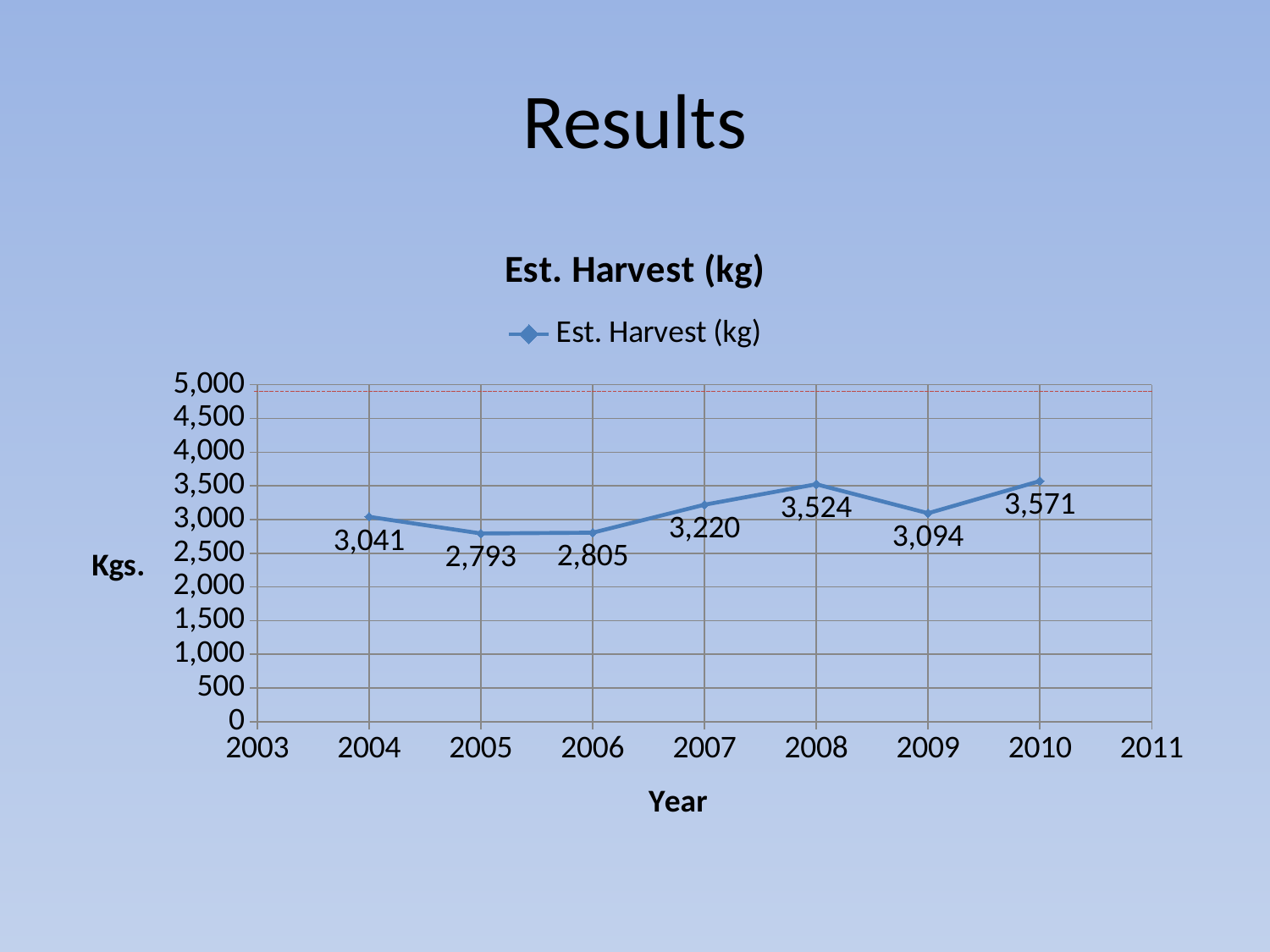
Which year has the lowest estimated harvest? 2005 Which year has the highest estimated harvest? 2010 How many data points are plotted on the chart? 7 What is the difference between the estimated harvest in 2010 and in 2004? 530 What is the difference between the estimated harvest in 2008 and in 2009? 430 What is the label on the vertical axis of the chart? Kgs. Is the estimated harvest for 2006 greater or less than 3,000? less Which year has a larger estimated harvest, 2007 or 2009? 2007 What is the estimated harvest for 2004? 3,041 What is the estimated harvest for 2008? 3,524 What kind of chart is shown on the slide? line chart What is the estimated harvest for 2009? 3,094